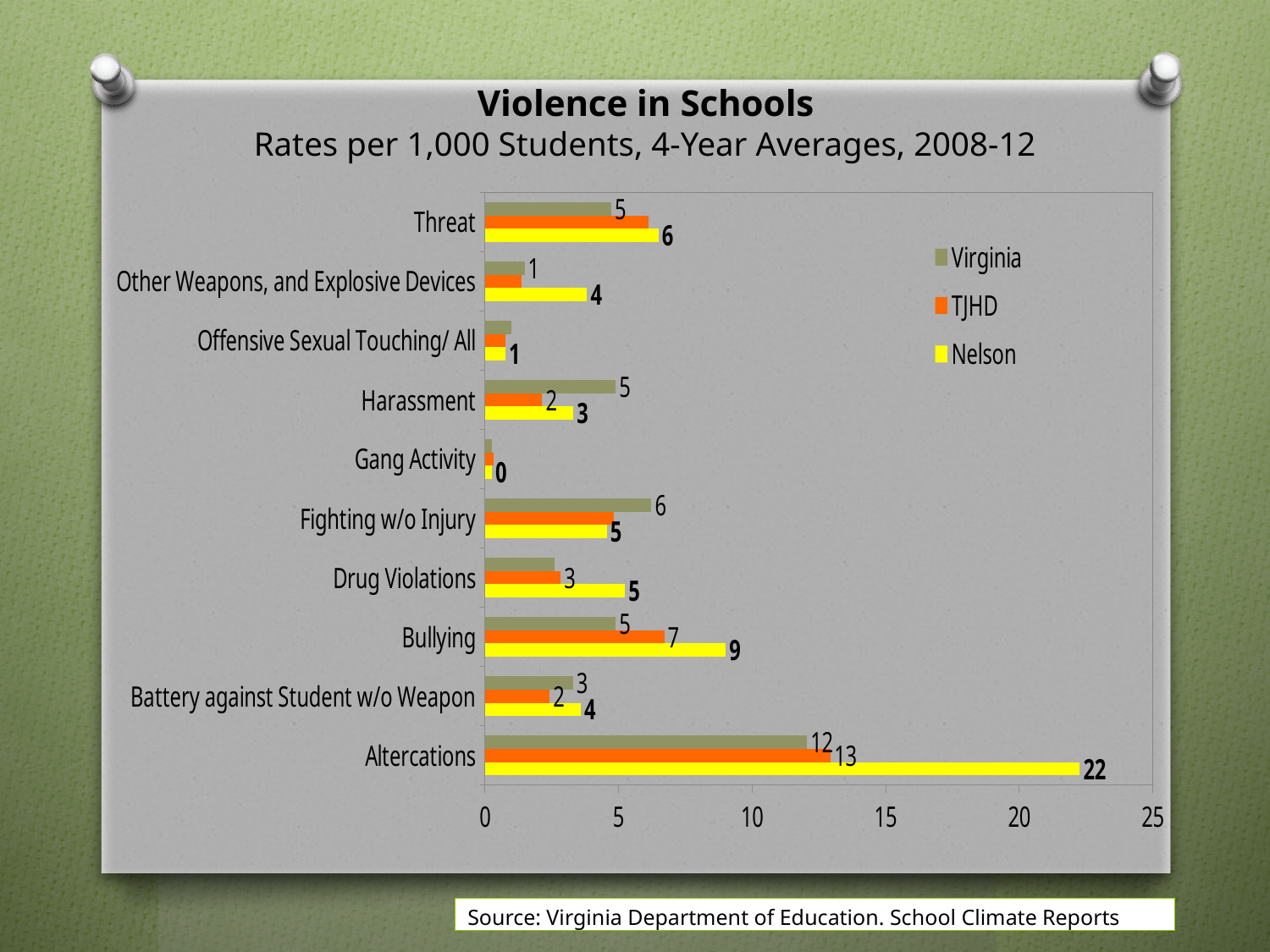
How many categories are shown on the chart? 10 What is the Nelson value for Altercations? 22 For which category is the Nelson value lowest? Gang Activity What is the difference between the Nelson and TJHD values for Altercations? 9 For which category is the Nelson value highest? Altercations How many series does the legend list? 3 What is the Virginia value for Harassment? 5 What is the Nelson value for Gang Activity? 0 What is the TJHD value for Bullying? 7 For Bullying, which is larger: the TJHD value or the Virginia value? TJHD Is the TJHD value for Other Weapons, and Explosive Devices greater or less than 5? less What kind of chart is shown on the slide? Bar chart